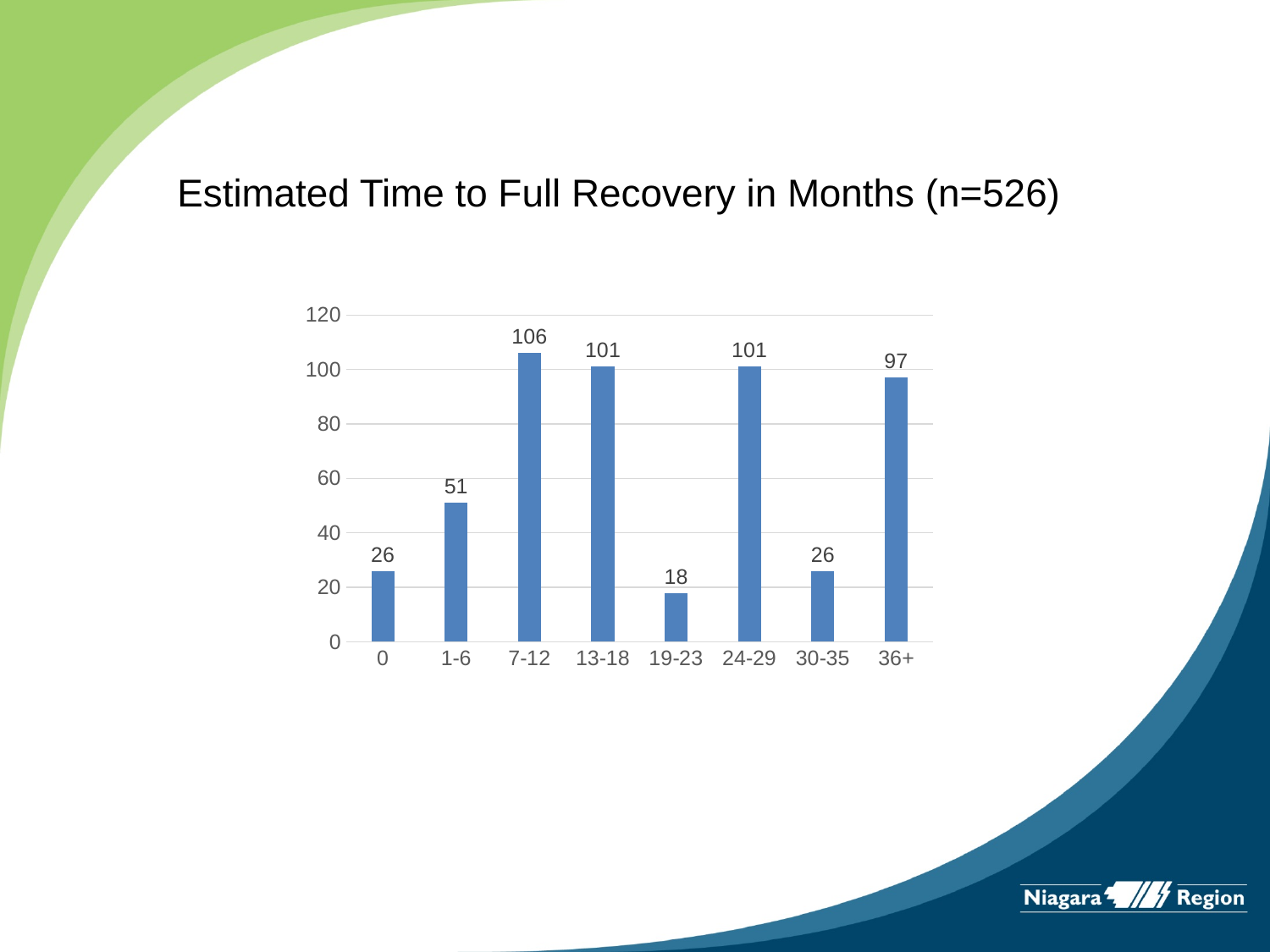
What kind of chart is shown on the slide? bar chart Which category has the highest value? 7-12 What is the difference between the values for 7-12 and 19-23? 88 What is the value for the 1-6 months category? 51 How many categories are shown on the x axis? 8 Which is larger, the value for 36+ or the value for 1-6? 36+ What is the difference between the values for 1-6 and 0? 25 Which category has the lowest value? 19-23 What is the value for the 36+ months category? 97 What is the title of the chart? Estimated Time to Full Recovery in Months (n=526) What is the value for the 7-12 months category? 106 Is the value for 24-29 greater or less than 80? greater